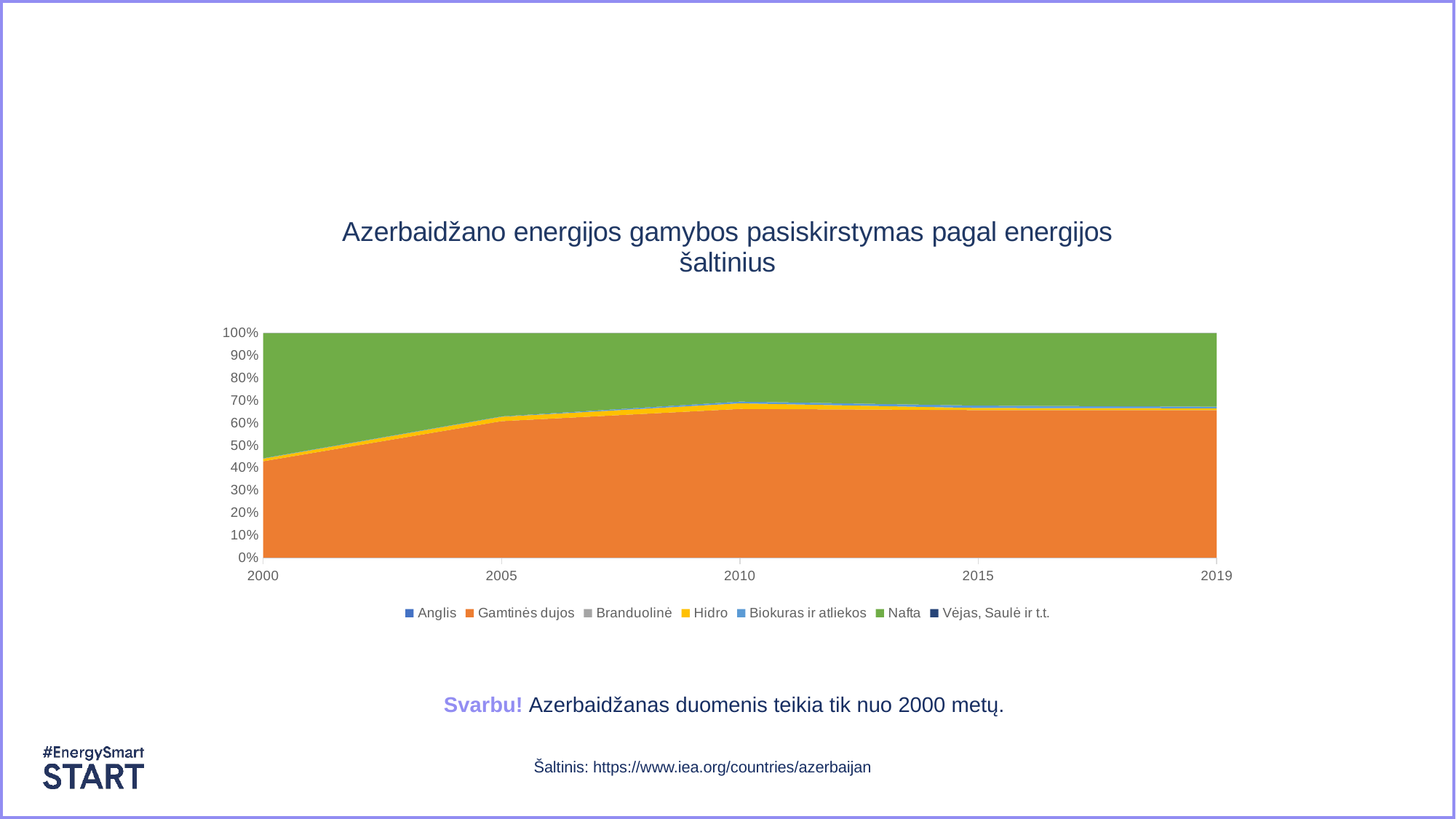
Is the share of Nafta in 2019 greater or less than 40%? less Does the share of Nafta rise or fall between 2000 and 2010? Falls Does the share of Gamtinės dujos rise or fall between 2000 and 2010? Rises What kind of chart is shown on the slide? Stacked area chart Is the share of Gamtinės dujos in 2000 greater or less than 50%? less What is the title of the chart? Azerbaidžano energijos gamybos pasiskirstymas pagal energijos šaltinius In 2000, which has the larger share: Nafta or Gamtinės dujos? Nafta Is the share of Gamtinės dujos in 2019 greater or less than 60%? greater How many year labels are shown on the x axis? 5 Which colour represents Nafta in the chart? Green How many series does the legend list? 7 In 2019, which has the larger share: Nafta or Gamtinės dujos? Gamtinės dujos